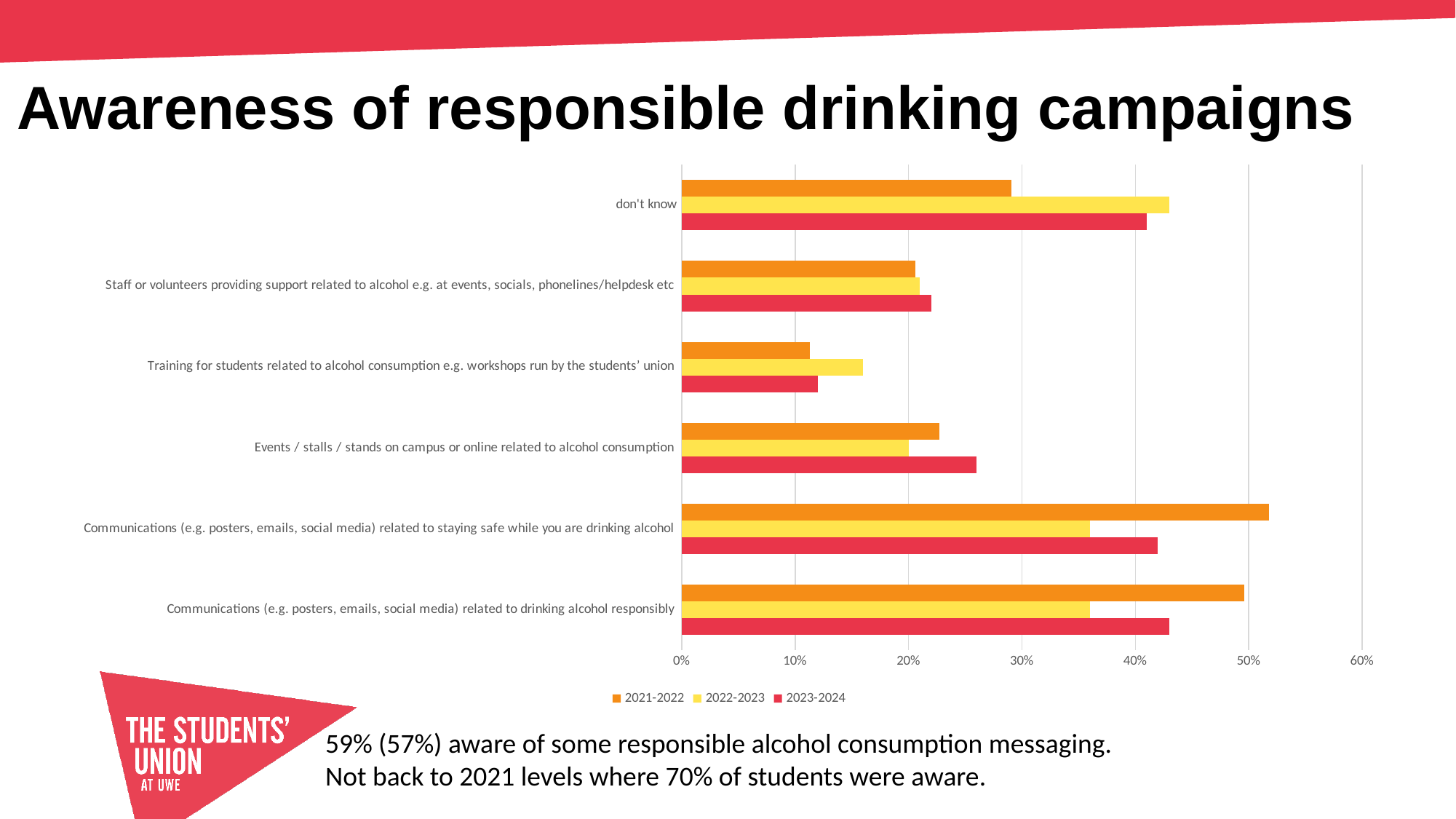
Which series are listed in the legend? 2021-2022, 2022-2023, 2023-2024 For "don't know", which series has the larger value: 2021-2022 or 2022-2023? 2022-2023 Which category has the lowest value for the 2021-2022 series? Training for students related to alcohol consumption e.g. workshops run by the students' union How many categories are plotted on the chart? 6 Which category has the highest value for the 2022-2023 series? don't know For "Events / stalls / stands on campus or online related to alcohol consumption", which series has the larger value: 2022-2023 or 2023-2024? 2023-2024 Is the 2021-2022 value for "Training for students related to alcohol consumption e.g. workshops run by the students' union" greater or less than 20%? less What kind of chart is shown on the slide? bar chart How many series does the legend list? 3 Which category has the lowest value for the 2023-2024 series? Training for students related to alcohol consumption e.g. workshops run by the students' union Is the 2022-2023 value for "Communications (e.g. posters, emails, social media) related to drinking alcohol responsibly" greater or less than 40%? less Is the 2022-2023 value for "don't know" greater or less than 40%? greater